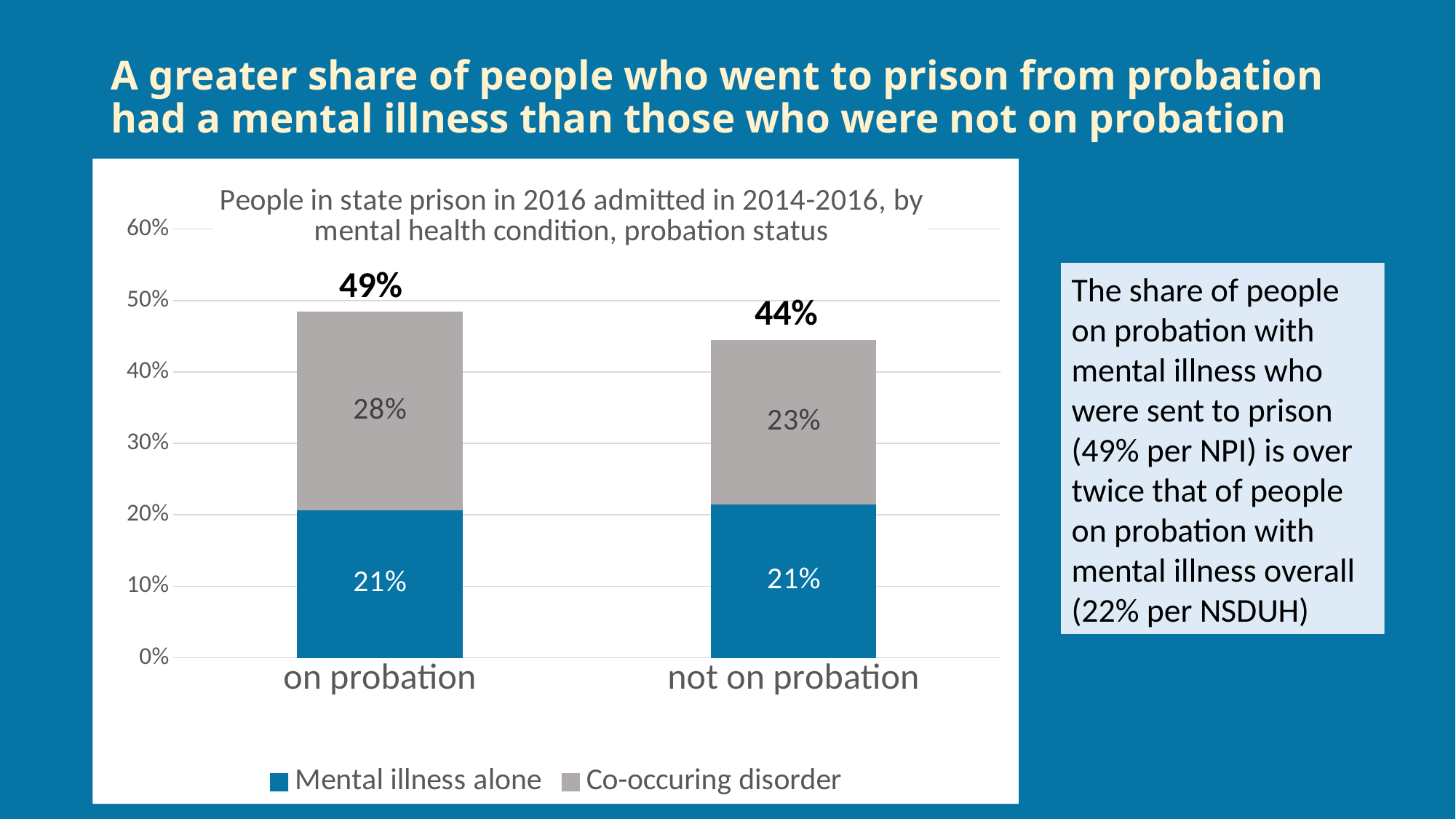
What is the difference between the Co-occuring disorder values for on probation and not on probation? 5% What kind of chart is shown on the slide? stacked bar chart Which category has the higher total, on probation or not on probation? on probation Which series is shown in blue in the legend? Mental illness alone What is the value for Co-occuring disorder for the not on probation category? 23% What is the difference between the total for on probation and the total for not on probation? 5% How many categories are shown on the x axis? 2 What is the value for Co-occuring disorder for the on probation category? 28% What is the total of the stacked bar for on probation? 49% How many series does the legend list? 2 What is the total of the stacked bar for not on probation? 44% What is the value for Mental illness alone for the on probation category? 21%